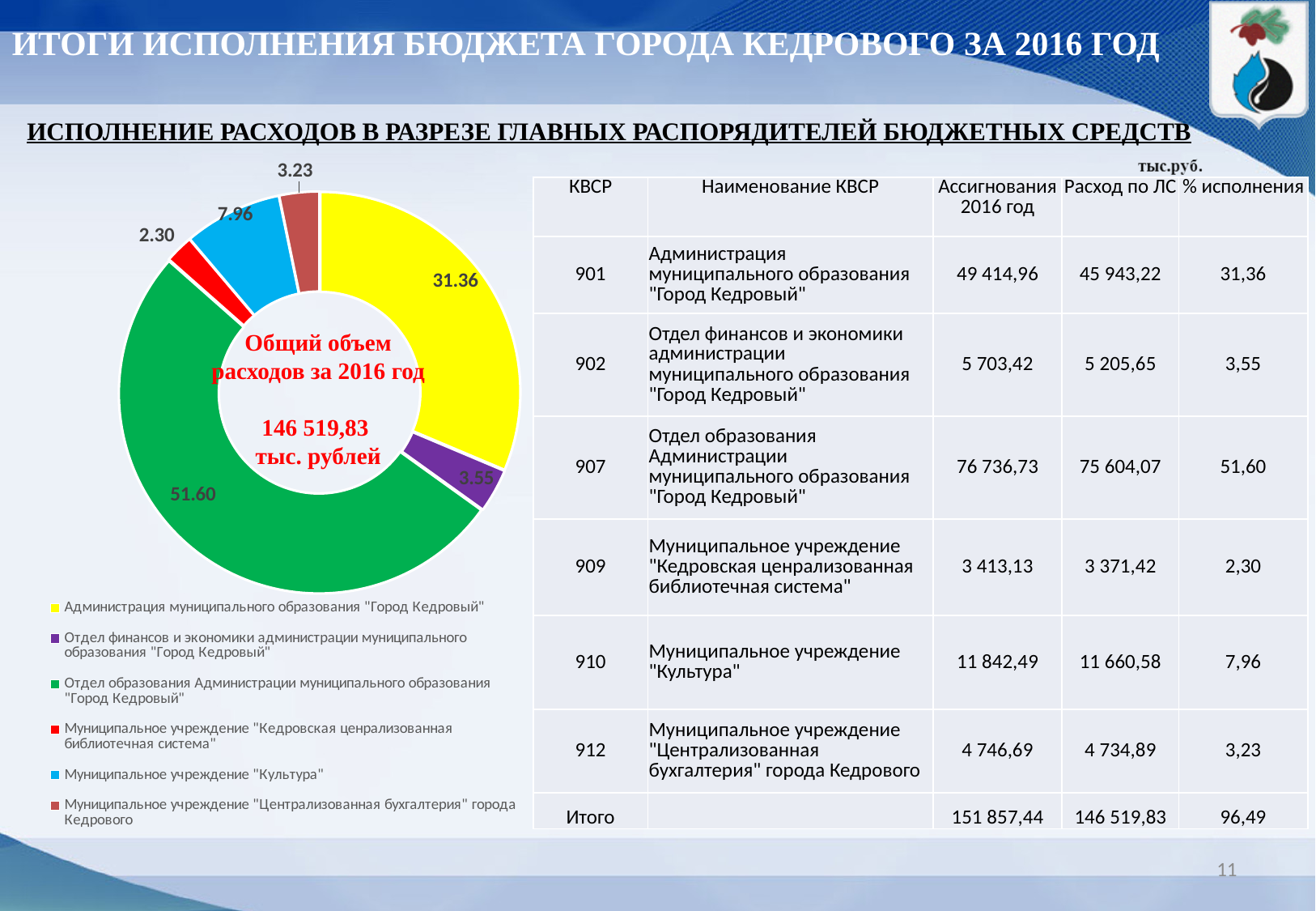
What is the difference between the values for "Отдел образования Администрации муниципального образования "Город Кедровый"" and "Администрация муниципального образования "Город Кедровый""? 20.24 What colour is the slice for "Муниципальное учреждение "Культура""? Blue What value is shown for the slice "Муниципальное учреждение "Кедровская ценрализованная библиотечная система""? 2.30 What type of chart is shown on the slide? Doughnut (pie) chart Which category has the smallest slice in the doughnut chart? Муниципальное учреждение "Кедровская ценрализованная библиотечная система" What value is shown for the slice "Отдел образования Администрации муниципального образования "Город Кедровый""? 51.60 What total expenditure amount is written in the centre of the doughnut chart? 146 519,83 тыс. рублей What value is shown for the slice "Администрация муниципального образования "Город Кедровый""? 31.36 Which category has the largest slice in the doughnut chart? Отдел образования Администрации муниципального образования "Город Кедровый" Which is larger: the slice for "Отдел финансов и экономики администрации муниципального образования "Город Кедровый"" or the slice for "Муниципальное учреждение "Централизованная бухгалтерия" города Кедрового"? Отдел финансов и экономики администрации муниципального образования "Город Кедровый" How many slices does the doughnut chart have? 6 What value is shown for the slice "Муниципальное учреждение "Культура""? 7.96